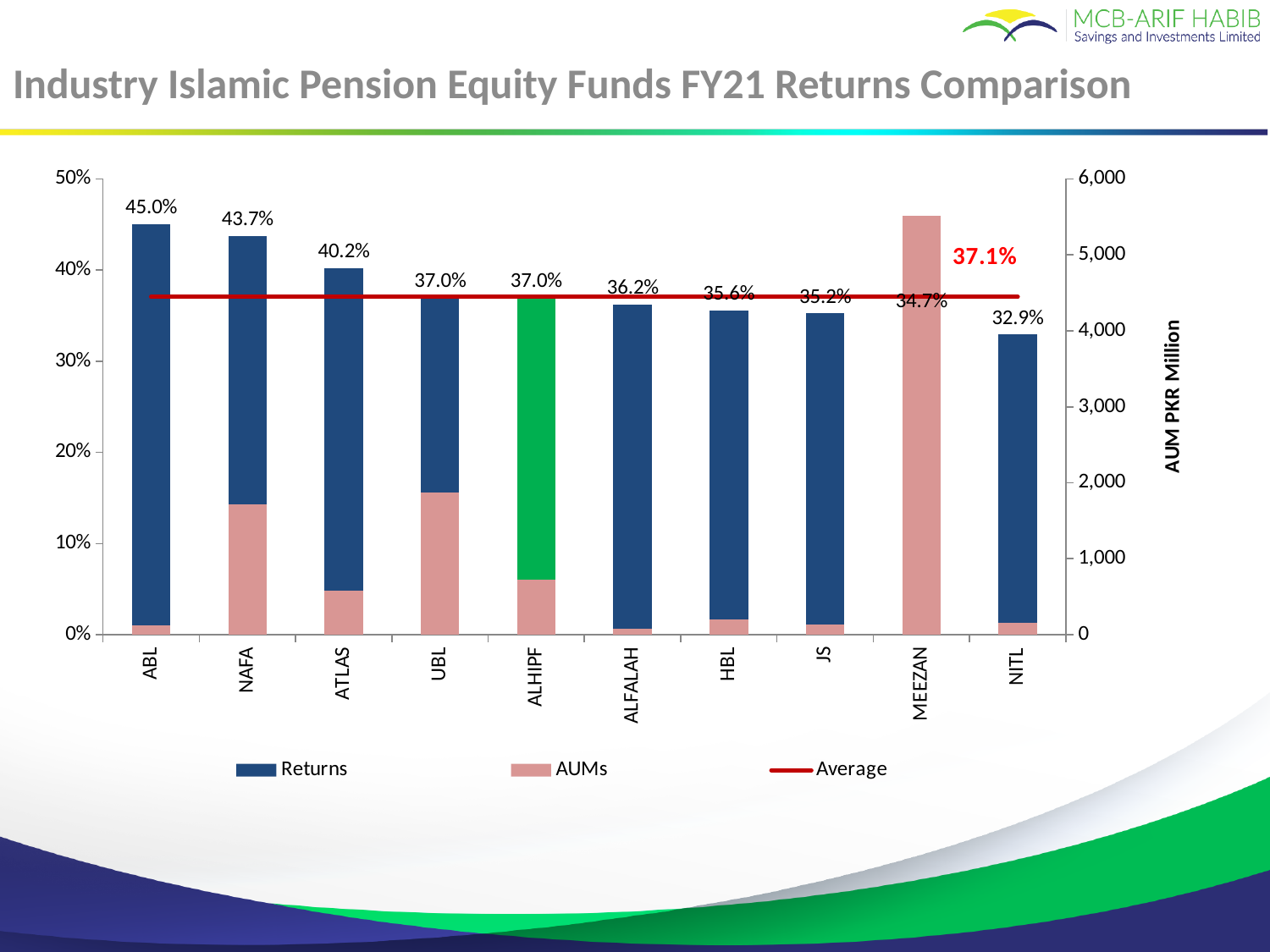
What is the FY21 return for ABL? 45.0% What is the average return shown by the red line? 37.1% How many funds are shown on the x axis? 10 How many entries does the legend list? 3 Which fund has the highest FY21 return? ABL Which fund has the lowest FY21 return? NITL Is the AUM value for MEEZAN greater or less than 5,000 PKR Million? greater What is the difference between the returns of ABL and NITL? 12.1% What kind of chart is used to show the returns? Bar chart What is the FY21 return for MEEZAN? 34.7% Which fund has the higher return, NAFA or ATLAS? NAFA Which fund has the largest AUM bar? MEEZAN